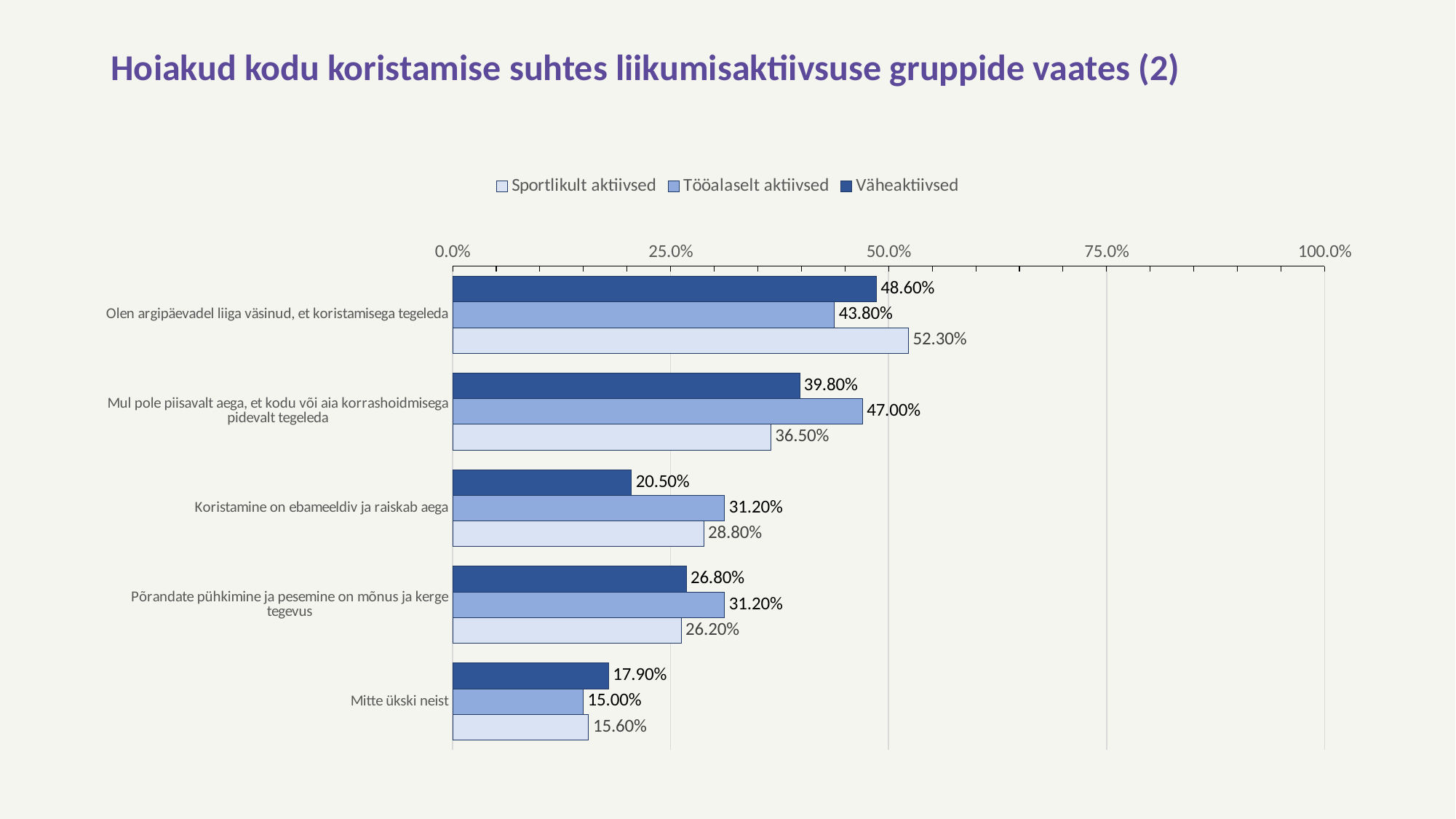
Which category has the lowest value for the Tööalaselt aktiivsed series? Mitte ükski neist What is the value for Sportlikult aktiivsed in the category "Olen argipäevadel liiga väsinud, et koristamisega tegeleda"? 52.30% What is the title of the slide? Hoiakud kodu koristamise suhtes liikumisaktiivsuse gruppide vaates (2) In the category "Mul pole piisavalt aega, et kodu või aia korrashoidmisega pidevalt tegeleda", which series has the larger value: Väheaktiivsed or Sportlikult aktiivsed? Väheaktiivsed How many categories are shown on the chart? 5 What is the difference between the Sportlikult aktiivsed and Väheaktiivsed values in the category "Koristamine on ebameeldiv ja raiskab aega"? 8.30% Is the value for Sportlikult aktiivsed in the category "Olen argipäevadel liiga väsinud, et koristamisega tegeleda" greater or less than 50.0%? greater What kind of chart is shown on the slide? Bar chart How many series does the legend list? 3 Which category has the highest value for the Väheaktiivsed series? Olen argipäevadel liiga väsinud, et koristamisega tegeleda What is the value for Väheaktiivsed in the category "Mitte ükski neist"? 17.90% What is the value for Tööalaselt aktiivsed in the category "Mul pole piisavalt aega, et kodu või aia korrashoidmisega pidevalt tegeleda"? 47.00%